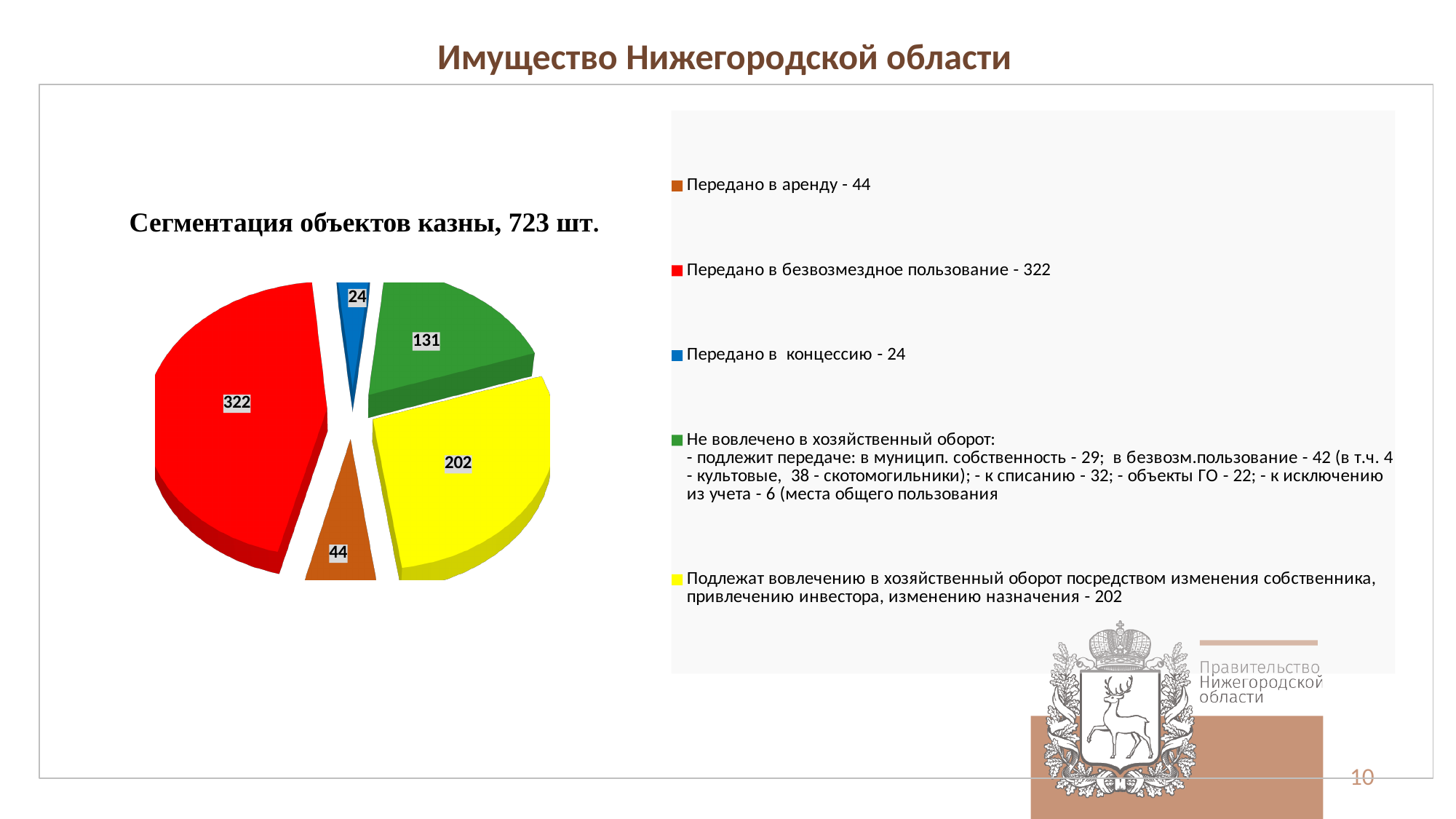
Which is larger: the value for "Не вовлечено в хозяйственный оборот" or the value for "Передано в аренду"? Не вовлечено в хозяйственный оборот Which category has the largest slice of the pie? Передано в безвозмездное пользование Which category has the smallest slice of the pie? Передано в концессию What is the title of the chart? Сегментация объектов казны, 723 шт. How many slices does the pie chart have? 5 What colour is the slice for "Передано в концессию"? blue What is the value for "Передано в концессию"? 24 What is the value for "Не вовлечено в хозяйственный оборот"? 131 What is the difference between the value for "Передано в безвозмездное пользование" and the value for "Подлежат вовлечению в хозяйственный оборот посредством изменения собственника, привлечению инвестора, изменению назначения"? 120 What type of chart is shown on the slide? pie chart What is the value for "Передано в аренду"? 44 What is the value for "Передано в безвозмездное пользование"? 322